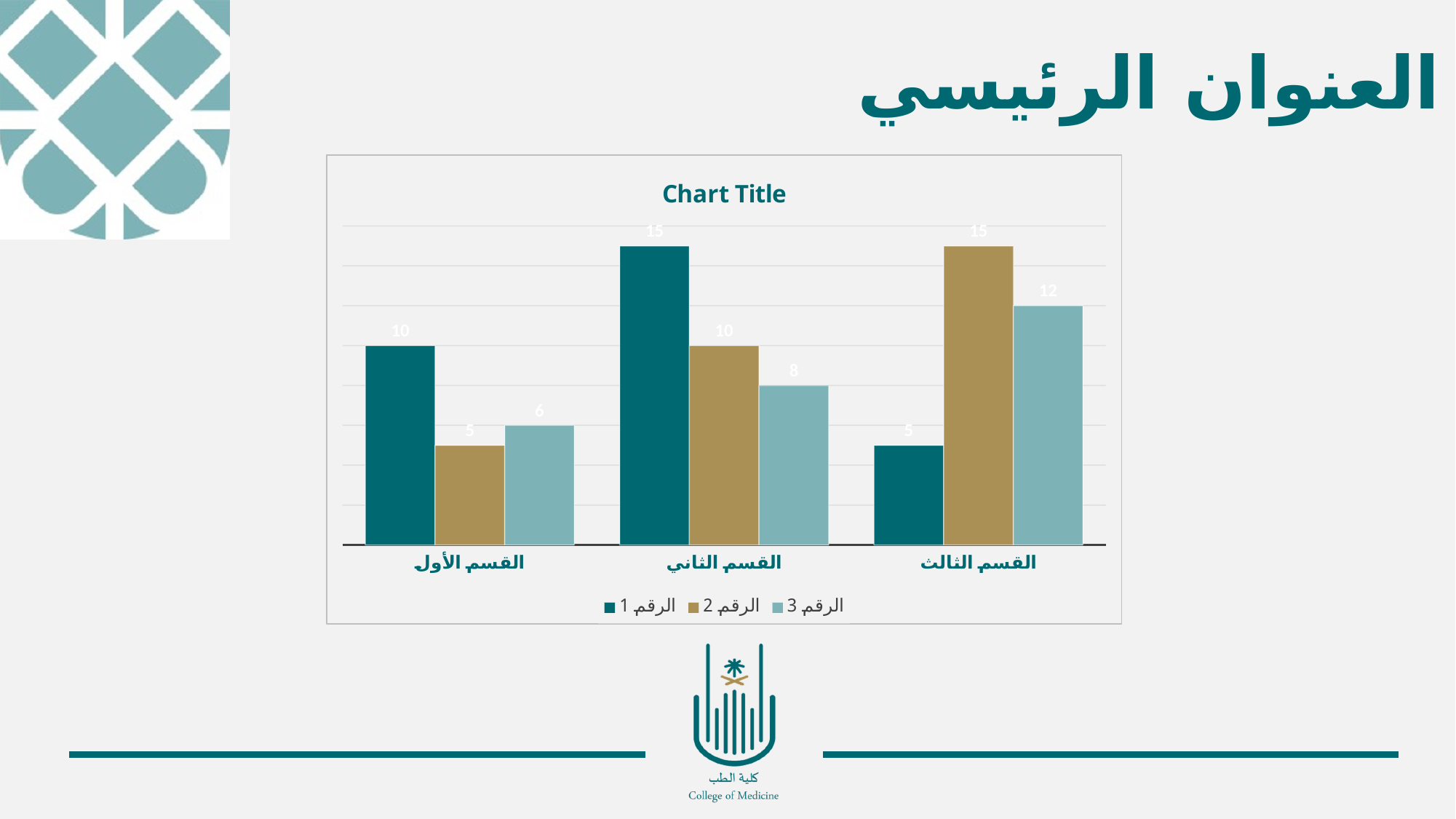
Which category has the lowest value for الرقم 2? القسم الأول What is the difference between الرقم 1 and الرقم 2 for القسم الثاني? 5 What is the value of الرقم 1 for القسم الأول? 10 What type of chart is shown on the slide? bar chart Which is larger for القسم الثالث: الرقم 3 or الرقم 1? الرقم 3 How many categories are shown on the x axis? 3 What is the title of the chart? Chart Title Does the value of الرقم 2 rise or fall from القسم الأول to القسم الثالث? rise What is the value of الرقم 3 for القسم الثاني? 8 What is the value of الرقم 2 for القسم الثالث? 15 How many series does the legend list? 3 Which category has the highest value for الرقم 1? القسم الثاني